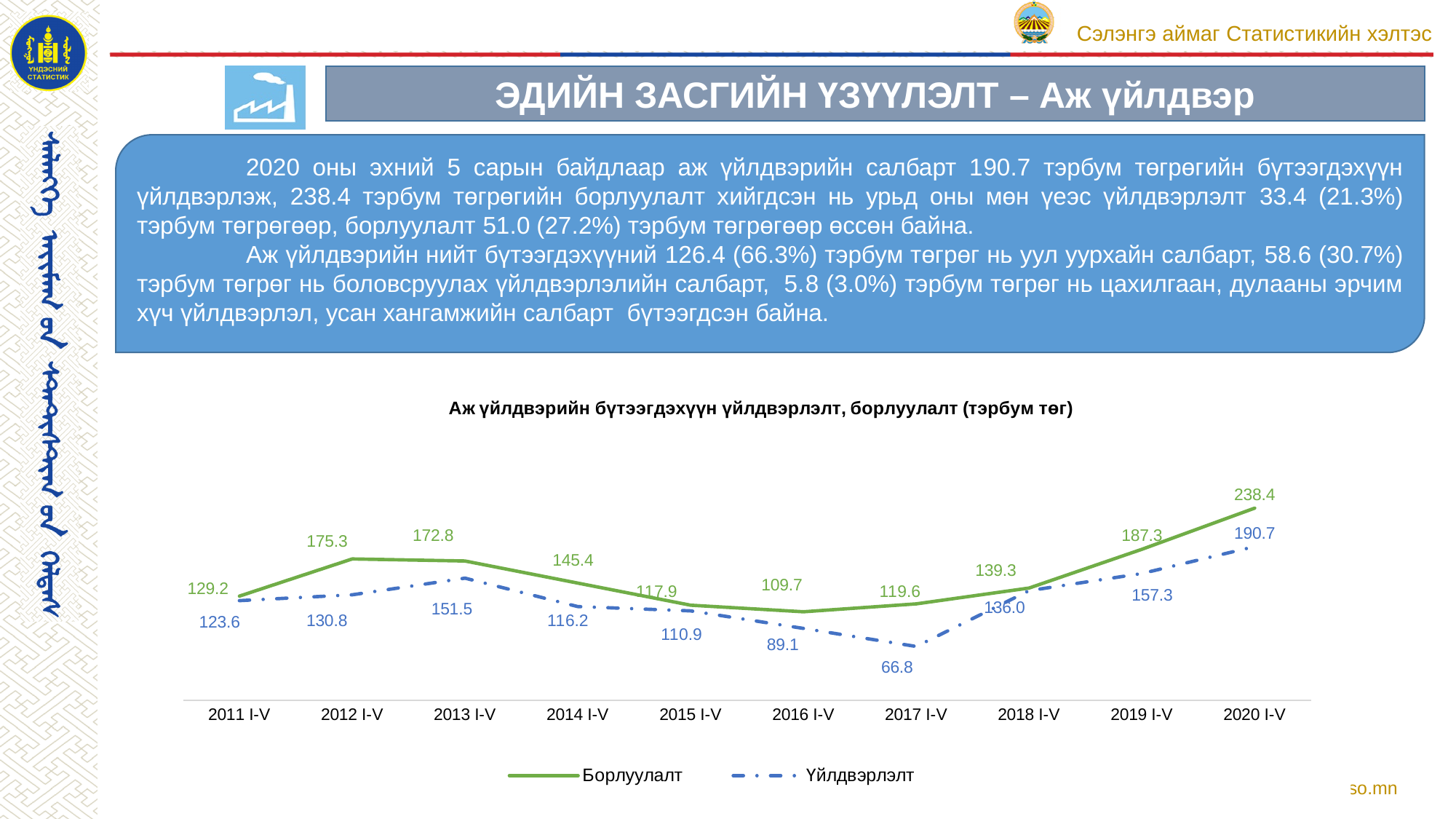
Does Борлуулалт rise or fall from 2017 I-V to 2020 I-V? Rise What is the title of the chart? Аж үйлдвэрийн бүтээгдэхүүн үйлдвэрлэлт, борлуулалт (тэрбум төг) How many series does the legend list? 2 Which is larger in 2013 I-V, Борлуулалт or Үйлдвэрлэлт? Борлуулалт What is the difference between Борлуулалт and Үйлдвэрлэлт in 2020 I-V? 47.7 How many time periods are plotted along the x axis? 10 What is the value of Үйлдвэрлэлт for 2017 I-V? 66.8 In which period is Үйлдвэрлэлт lowest? 2017 I-V What is the value of Үйлдвэрлэлт for 2013 I-V? 151.5 What type of chart is shown on the slide? Line chart What is the value of Борлуулалт for 2020 I-V? 238.4 In which period is Борлуулалт highest? 2020 I-V